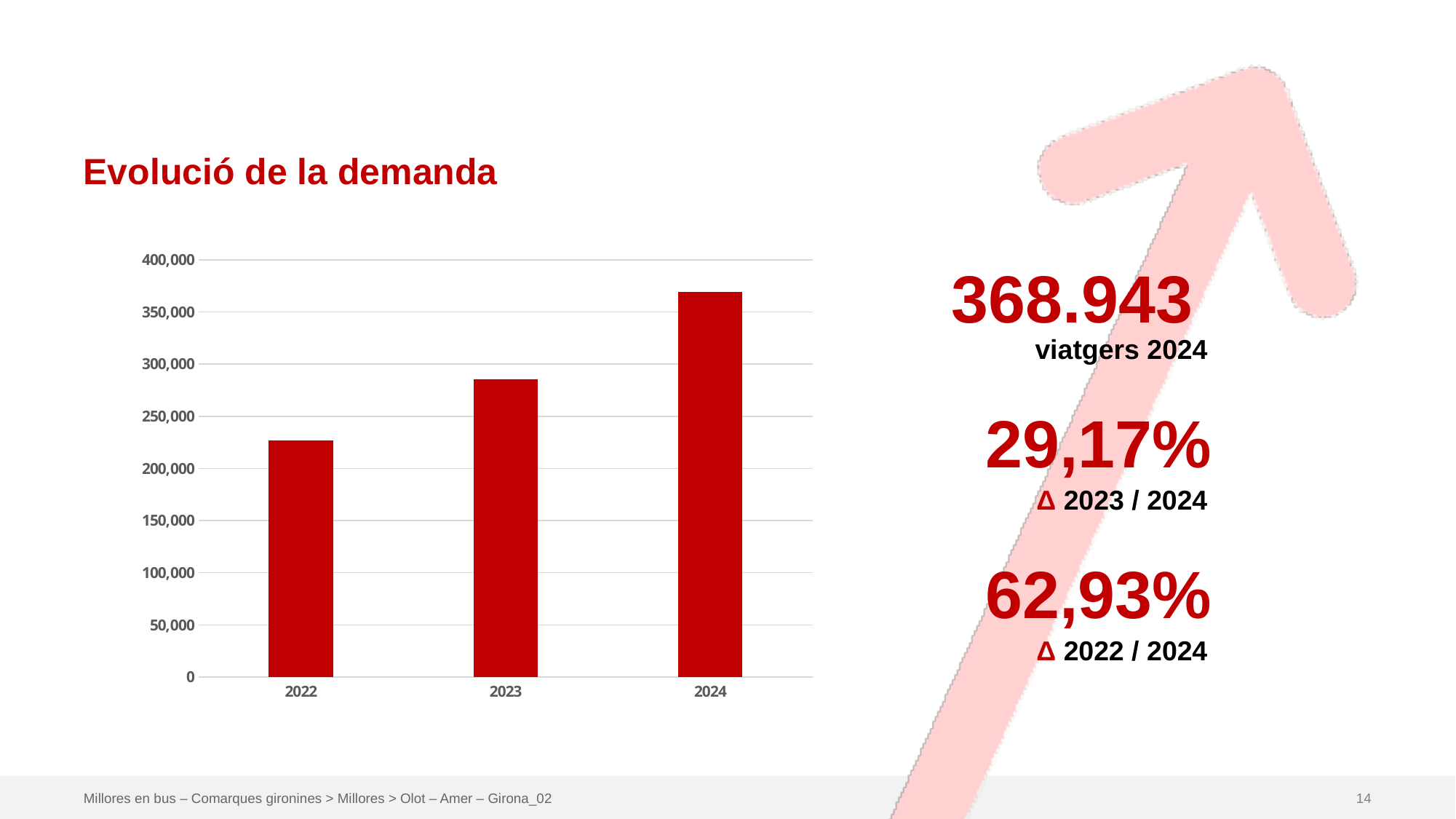
Is the value for 2022 greater or less than 250,000? less Do the values rise or fall from 2022 to 2024? rise How many years are shown on the x axis of the chart? 3 What kind of chart is shown on the slide? bar chart Is the value for 2022 greater or less than 200,000? greater What colour are the bars in the chart? red Which is larger, the value for 2023 or the value for 2022? 2023 Which year has the lowest bar in the chart? 2022 Which year has the highest bar in the chart? 2024 What is the title of the chart on the slide? Evolució de la demanda Is the value for 2024 greater or less than 350,000? greater